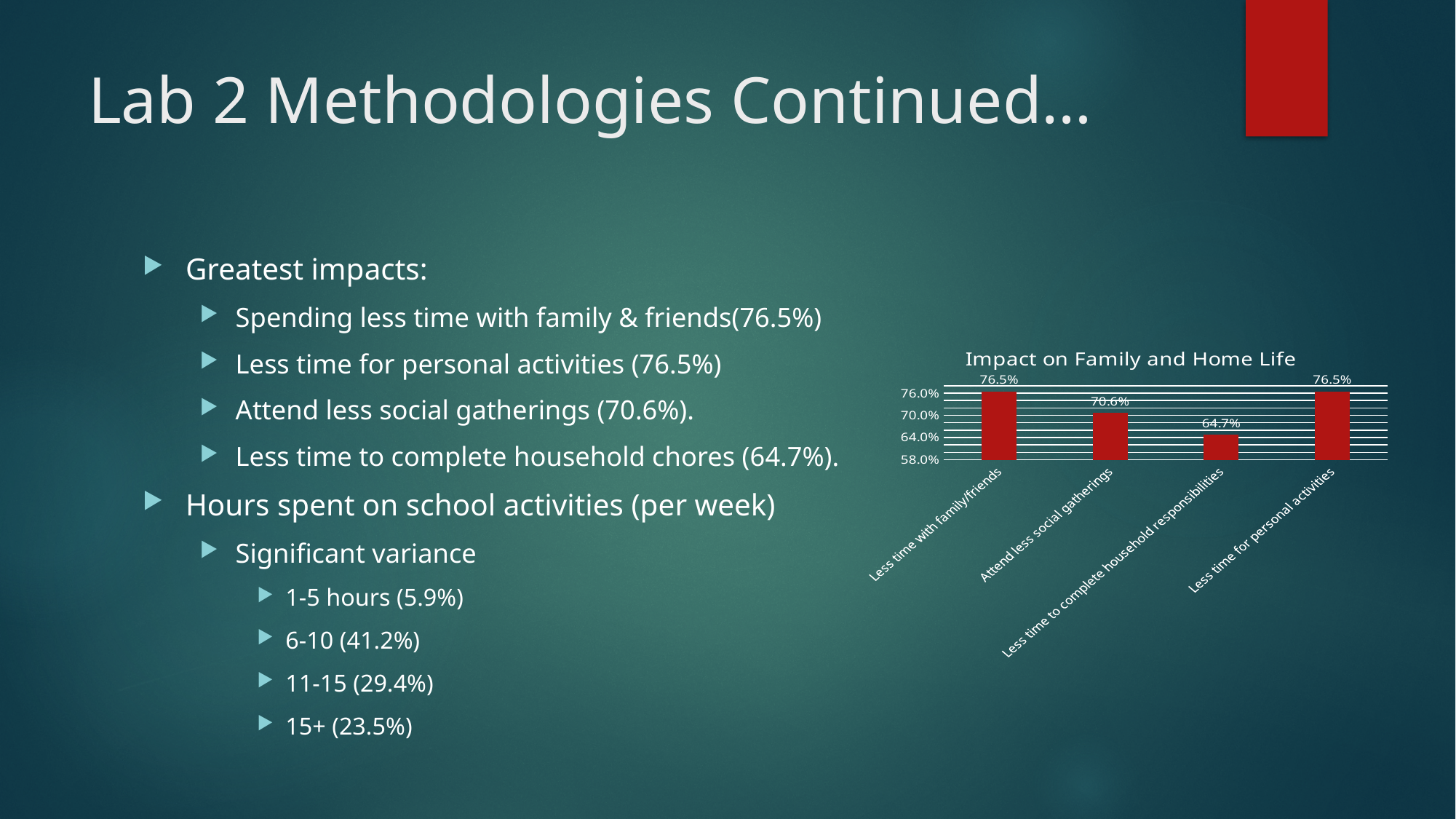
Is the value for 'Less time to complete household responsibilities' greater or less than 70.0%? less Which category has the lowest value in the Impact on Family and Home Life chart? Less time to complete household responsibilities What colour are the bars in the Impact on Family and Home Life chart? red How many categories are shown in the Impact on Family and Home Life chart? 4 What is the value for 'Less time to complete household responsibilities' in the chart? 64.7% Which is larger: the value for 'Attend less social gatherings' or 'Less time to complete household responsibilities'? Attend less social gatherings What is the difference between the values for 'Attend less social gatherings' and 'Less time to complete household responsibilities'? 5.9% What is the value for 'Less time with family/friends' in the chart? 76.5% What kind of chart is the Impact on Family and Home Life chart? bar chart What is the difference between the values for 'Less time with family/friends' and 'Attend less social gatherings'? 5.9% What is the value for 'Attend less social gatherings' in the Impact on Family and Home Life chart? 70.6% What is the title of the chart on the slide? Impact on Family and Home Life